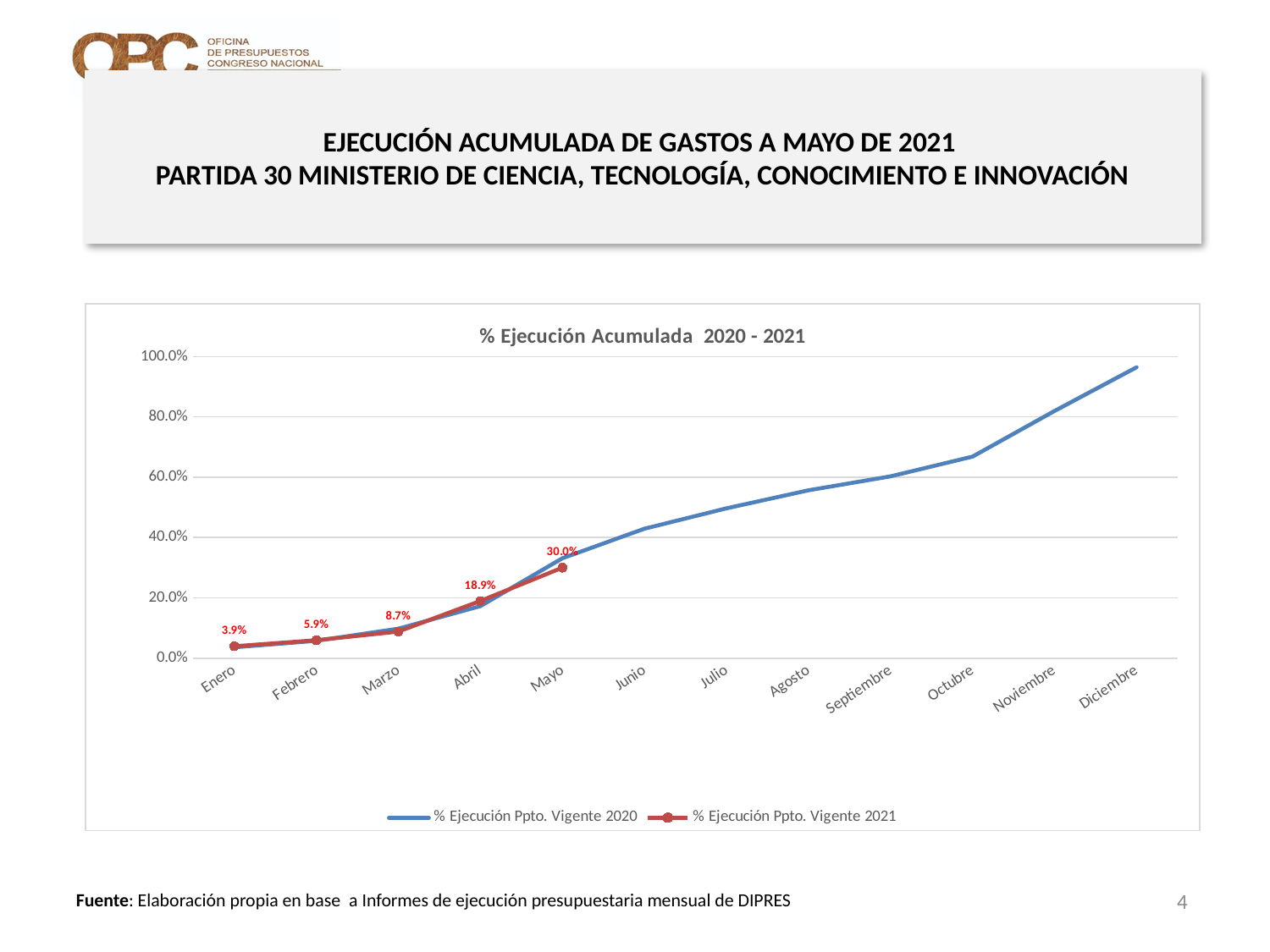
What is the value of % Ejecución Ppto. Vigente 2021 for Marzo? 8.7% How many series does the legend list? 2 How many months are shown on the x axis? 12 Which month has the lowest value for % Ejecución Ppto. Vigente 2021? Enero Is the value of % Ejecución Ppto. Vigente 2020 for Junio greater or less than 60.0%? less Which month has the highest value for % Ejecución Ppto. Vigente 2021? Mayo What is the value of % Ejecución Ppto. Vigente 2021 for Enero? 3.9% What is the value of % Ejecución Ppto. Vigente 2021 for Mayo? 30.0% What type of chart is shown on the slide? line chart Is the value of % Ejecución Ppto. Vigente 2020 for Diciembre greater or less than 80.0%? greater What is the title of the chart? % Ejecución Acumulada 2020 - 2021 What is the difference between the % Ejecución Ppto. Vigente 2021 values for Mayo and Abril? 11.1%